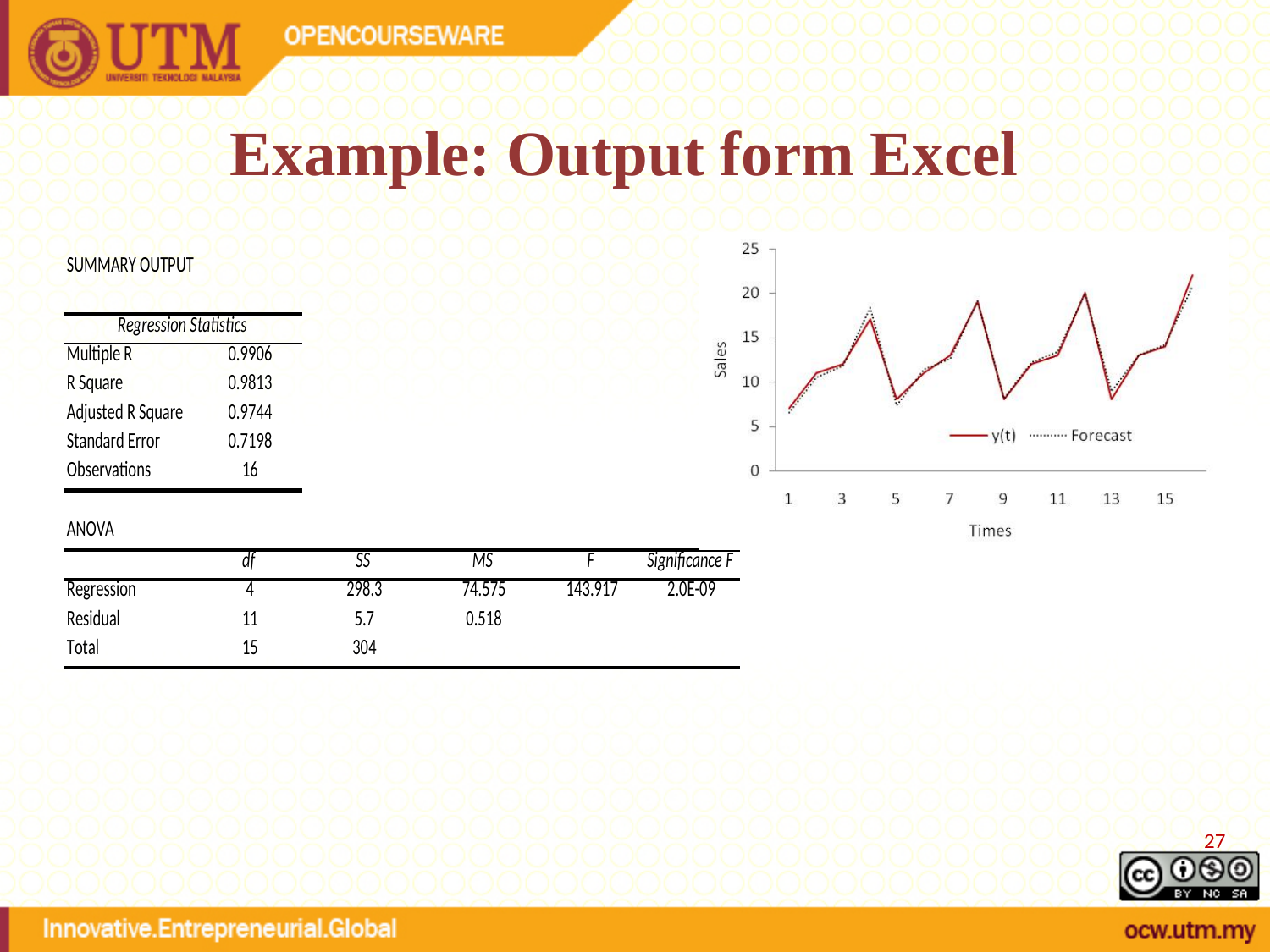
At which time does the y(t) series have its lowest value? 1 Is the value of y(t) at time 12 greater or less than 15? greater What is the label of the chart's vertical axis? Sales Is the value of y(t) at time 9 greater or less than 10? less Is the value of y(t) at time 4 greater or less than 15? greater What kind of chart is shown on the slide? line chart What are the two series named in the chart's legend? y(t) and Forecast How many series does the chart's legend list? 2 Which is larger for y(t): the value at time 8 or the value at time 9? time 8 At which time does the y(t) series reach its highest value? 16